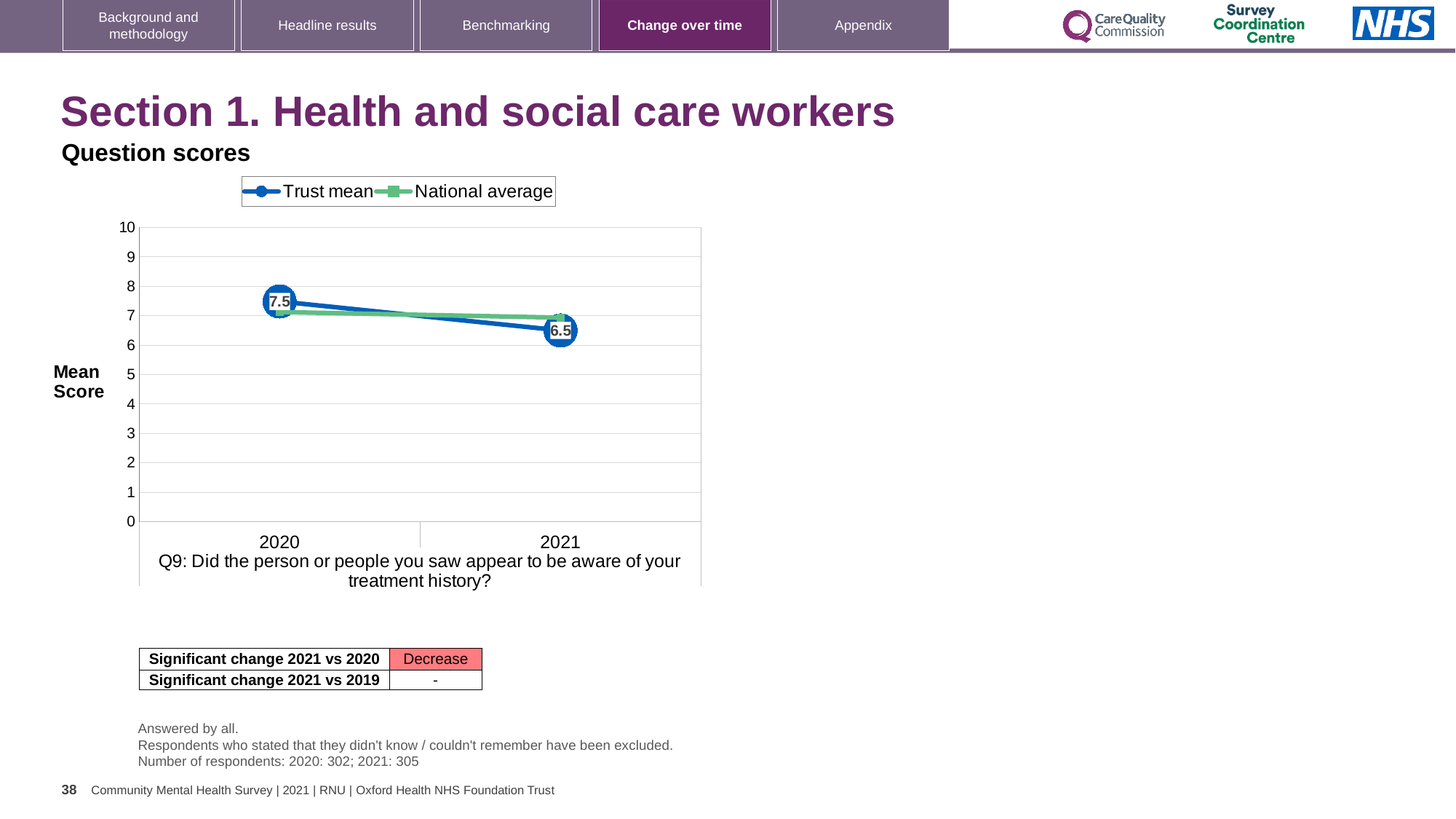
In which year is the Trust mean score higher? 2020 In 2021, which is larger: the Trust mean or the National average? National average What is the Trust mean score for 2020? 7.5 By how much did the Trust mean score change from 2020 to 2021? 1.0 How many series does the legend list? 2 Is the National average value for 2020 greater or less than 8? less Does the Trust mean rise or fall from 2020 to 2021? fall What is the Trust mean score for 2021? 6.5 What kind of chart is shown on the slide? line chart How many years are plotted on the x axis? 2 What is the label on the y axis of the chart? Mean Score Is the National average value for 2021 greater or less than 6? greater